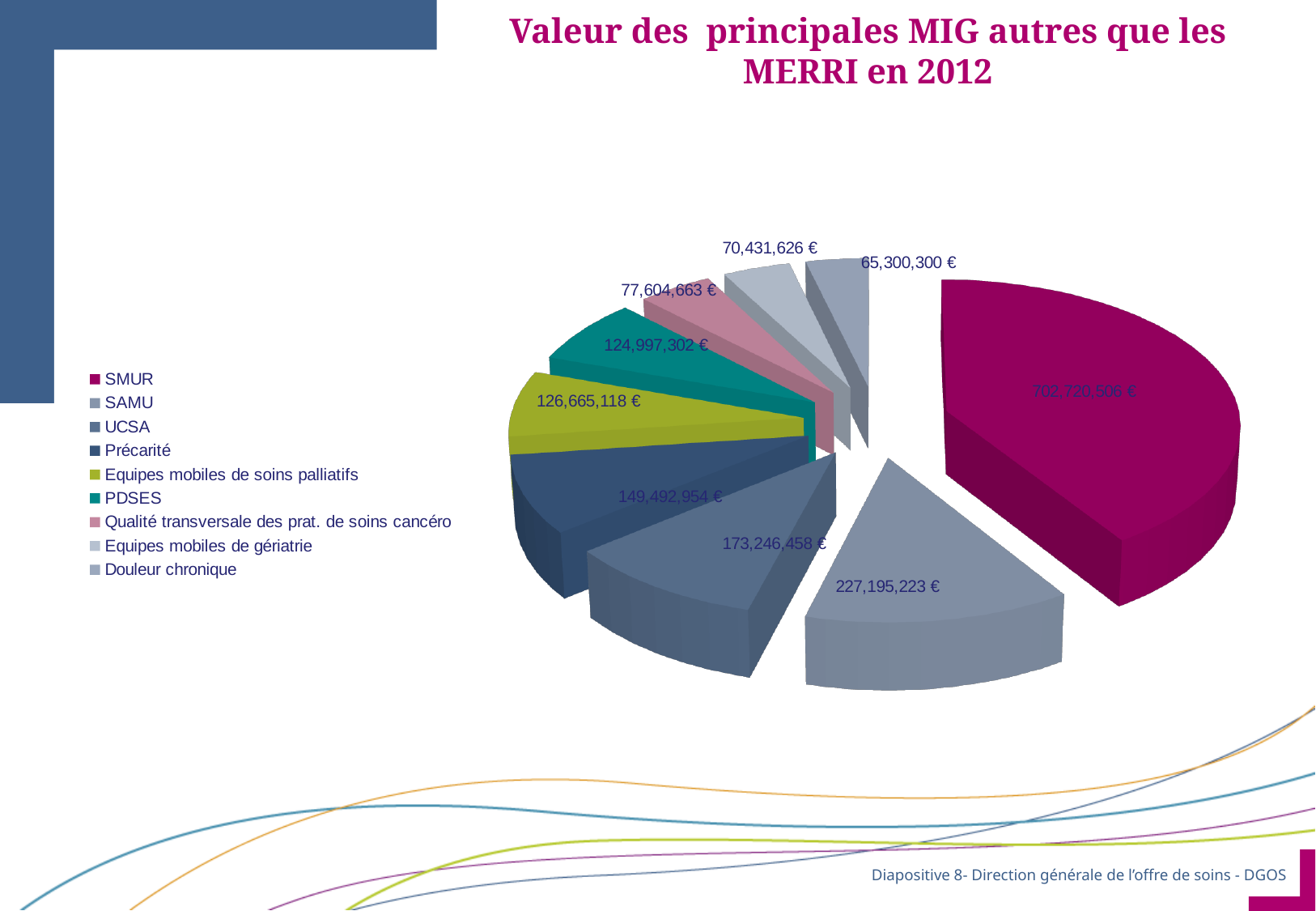
Which is larger, the value for UCSA or the value for Précarité? UCSA What is the value shown for SMUR? 702,720,506 € What is the difference between the values for SMUR and SAMU? 475,525,283 € What is the difference between the values for Equipes mobiles de soins palliatifs and PDSES? 1,667,816 € What type of chart is shown on the slide? Pie chart Which category has the smallest value? Douleur chronique How many categories are shown in the pie chart? 9 What is the value shown for Douleur chronique? 65,300,300 € What is the title of the slide? Valeur des principales MIG autres que les MERRI en 2012 What is the value shown for SAMU? 227,195,223 € Which category has the largest slice of the pie? SMUR What is the value shown for PDSES? 124,997,302 €